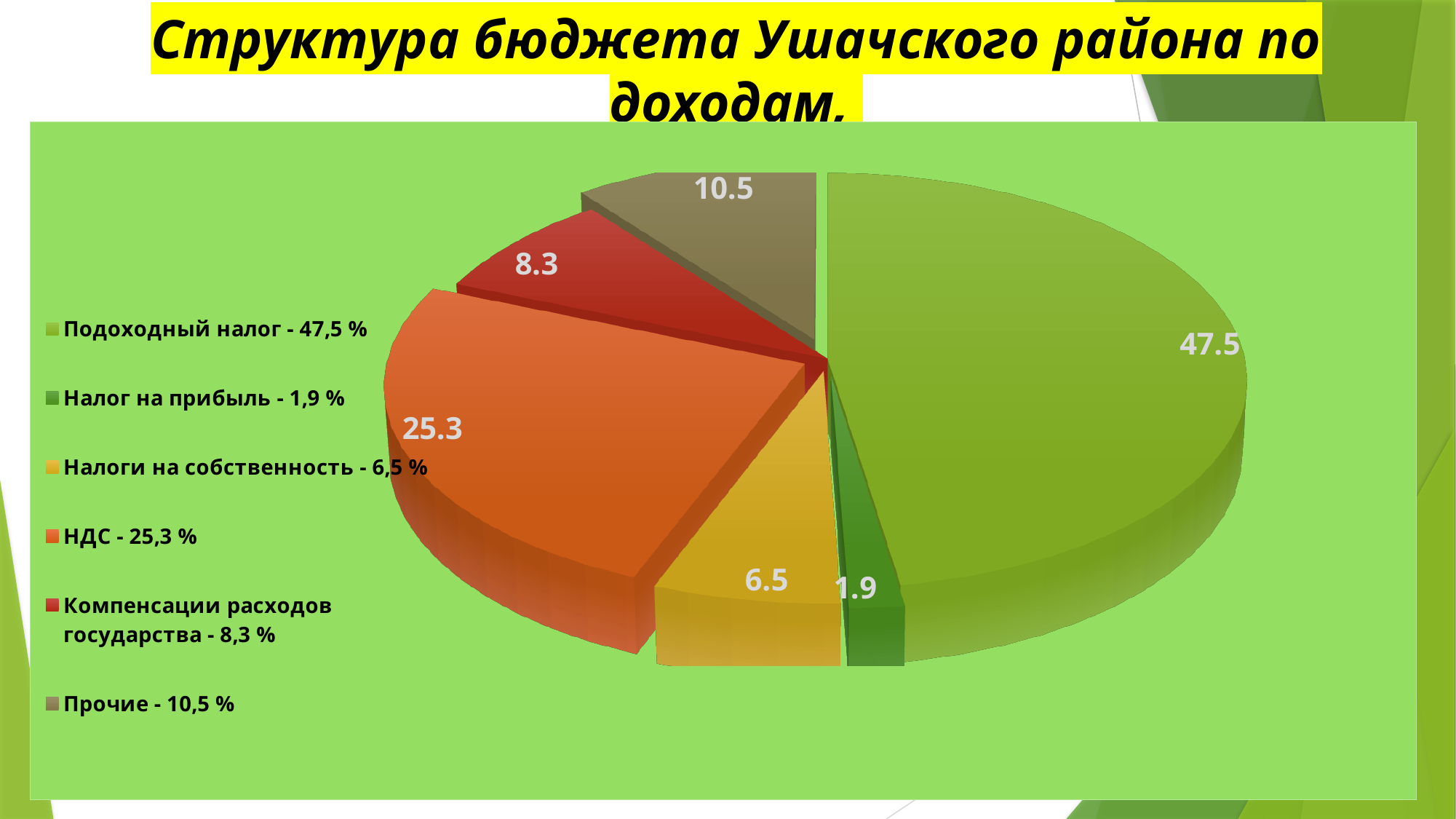
Which category has the largest slice of the pie? Подоходный налог What is the difference between the values for Подоходный налог and НДС? 22.2 What is the value shown for Подоходный налог? 47.5 What is the value shown for Прочие? 10.5 Which category has the smallest slice of the pie? Налог на прибыль What colour is the slice for НДС? orange How many slices does the pie chart have? 6 What is the value shown for НДС? 25.3 What is the value shown for Компенсации расходов государства? 8.3 What share of the pie does Налоги на собственность represent? 6.5% What kind of chart is shown on the slide? pie chart Which is larger, the value for Прочие or the value for Компенсации расходов государства? Прочие